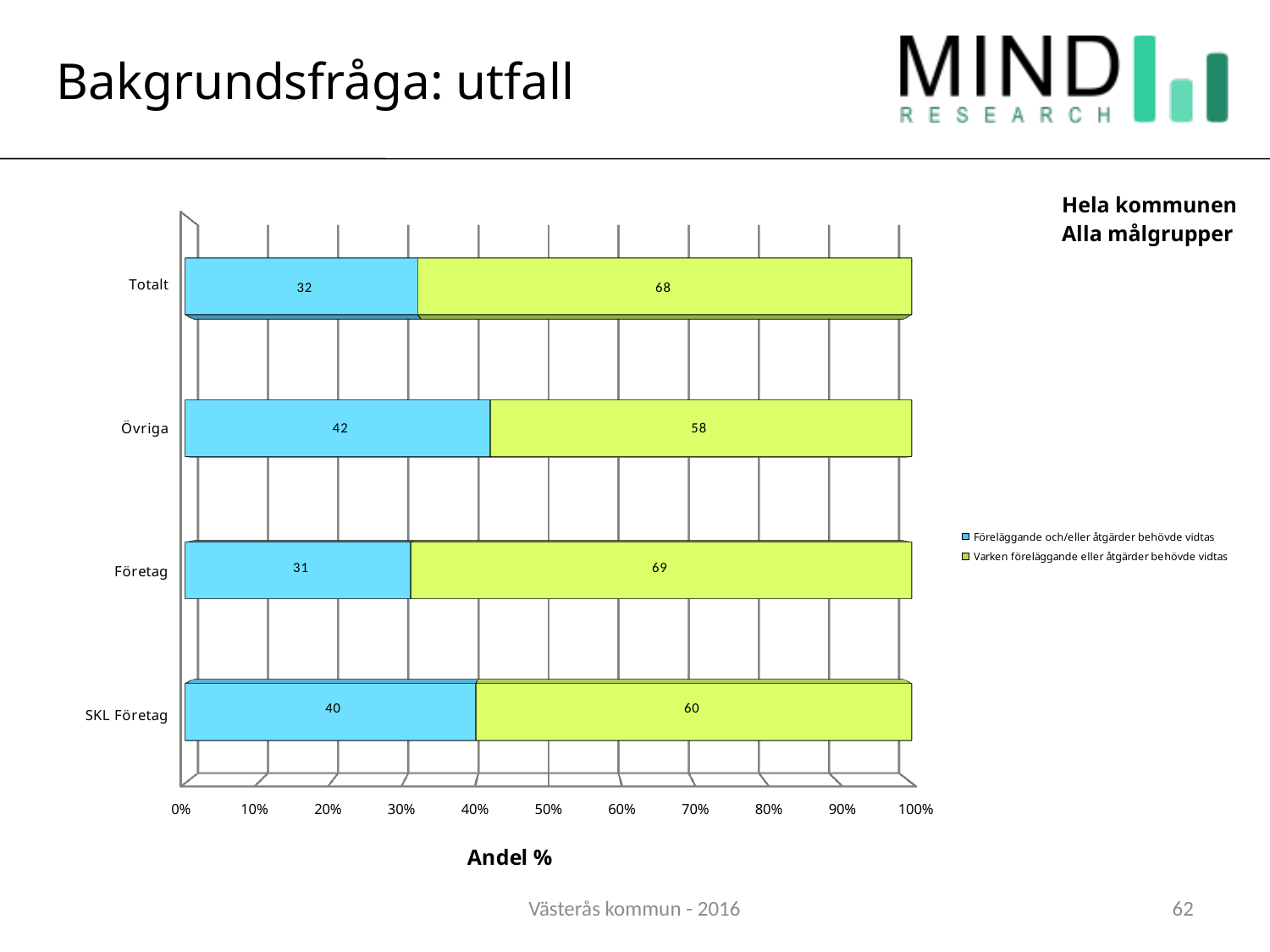
What kind of chart is shown on the slide? Stacked bar chart What is the total of the stacked bar for Företag? 100 Which category has the highest value in the 'Föreläggande och/eller åtgärder behövde vidtas' series? Övriga Which is larger: the 'Föreläggande och/eller åtgärder behövde vidtas' value for SKL Företag or for Totalt? SKL Företag What is the value for Övriga in the 'Varken föreläggande eller åtgärder behövde vidtas' series? 58 What is the label of the x axis? Andel % What is the difference between the 'Varken föreläggande eller åtgärder behövde vidtas' values for Företag and Övriga? 11 How many categories are shown on the y axis? 4 What is the value for SKL Företag in the 'Föreläggande och/eller åtgärder behövde vidtas' series? 40 Which category has the lowest value in the 'Föreläggande och/eller åtgärder behövde vidtas' series? Företag How many series does the legend list? 2 What is the value for Totalt in the 'Föreläggande och/eller åtgärder behövde vidtas' series? 32